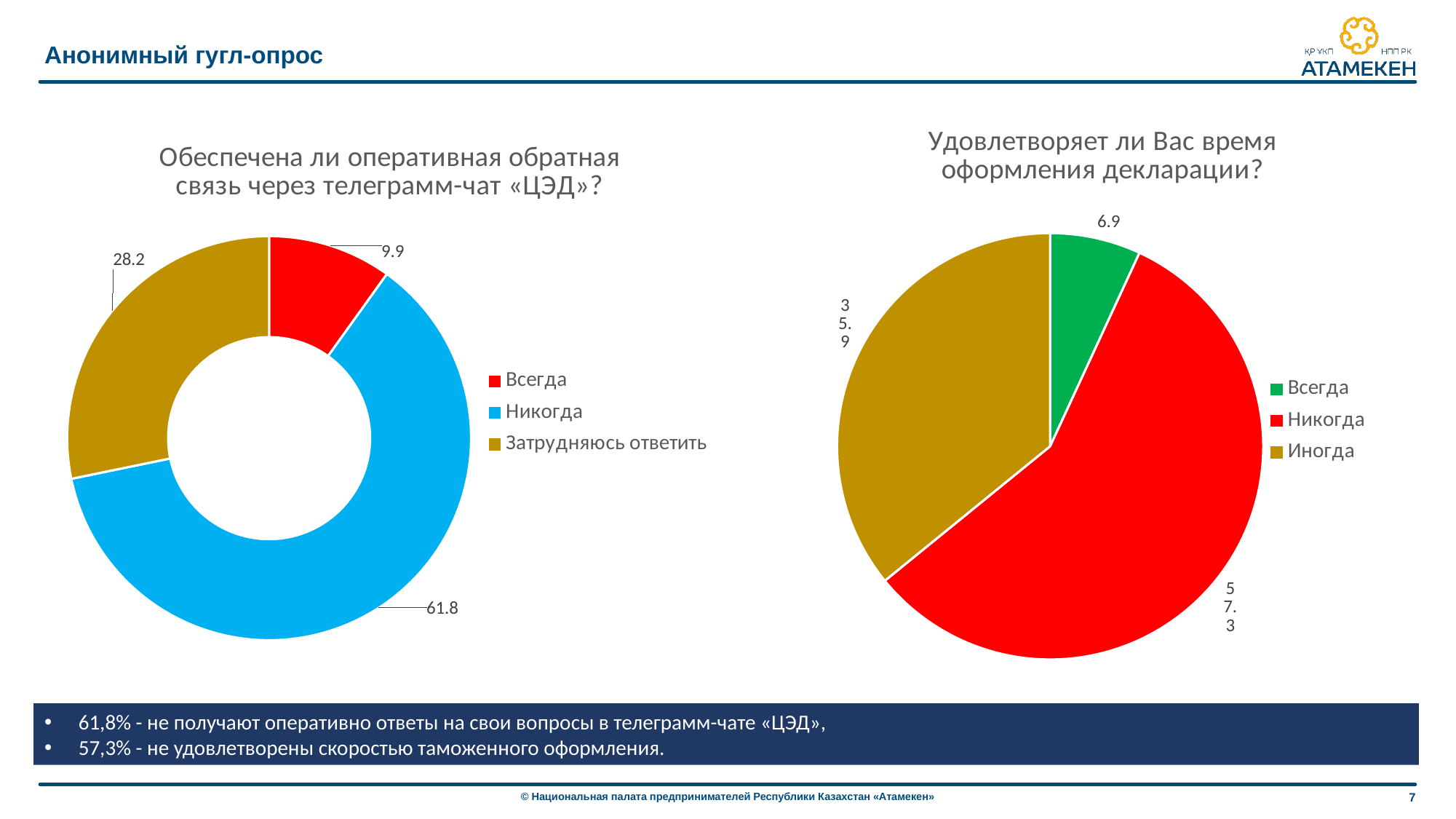
In the right chart (Удовлетворяет ли Вас время оформления декларации?), what is the value for Всегда? 6.9 In the left chart (Обеспечена ли оперативная обратная связь через телеграмм-чат «ЦЭД»?), which category has the largest share? Никогда In the right chart (Удовлетворяет ли Вас время оформления декларации?), which is larger, Никогда or Иногда? Никогда What kind of chart is the left chart (Обеспечена ли оперативная обратная связь через телеграмм-чат «ЦЭД»?)? Doughnut chart In the left chart (Обеспечена ли оперативная обратная связь через телеграмм-чат «ЦЭД»?), what is the difference between the values for Никогда and Затрудняюсь ответить? 33.6 In the left chart (Обеспечена ли оперативная обратная связь через телеграмм-чат «ЦЭД»?), what is the value for Никогда? 61.8 In the left chart (Обеспечена ли оперативная обратная связь через телеграмм-чат «ЦЭД»?), which category has the smallest share? Всегда In the right chart (Удовлетворяет ли Вас время оформления декларации?), what is the value for Никогда? 57.3 In the left chart (Обеспечена ли оперативная обратная связь через телеграмм-чат «ЦЭД»?), what is the value for Затрудняюсь ответить? 28.2 In the left chart (Обеспечена ли оперативная обратная связь через телеграмм-чат «ЦЭД»?), what is the value for Всегда? 9.9 How many categories does the legend of the right chart (Удовлетворяет ли Вас время оформления декларации?) list? 3 In the right chart (Удовлетворяет ли Вас время оформления декларации?), which category has the smallest share? Всегда